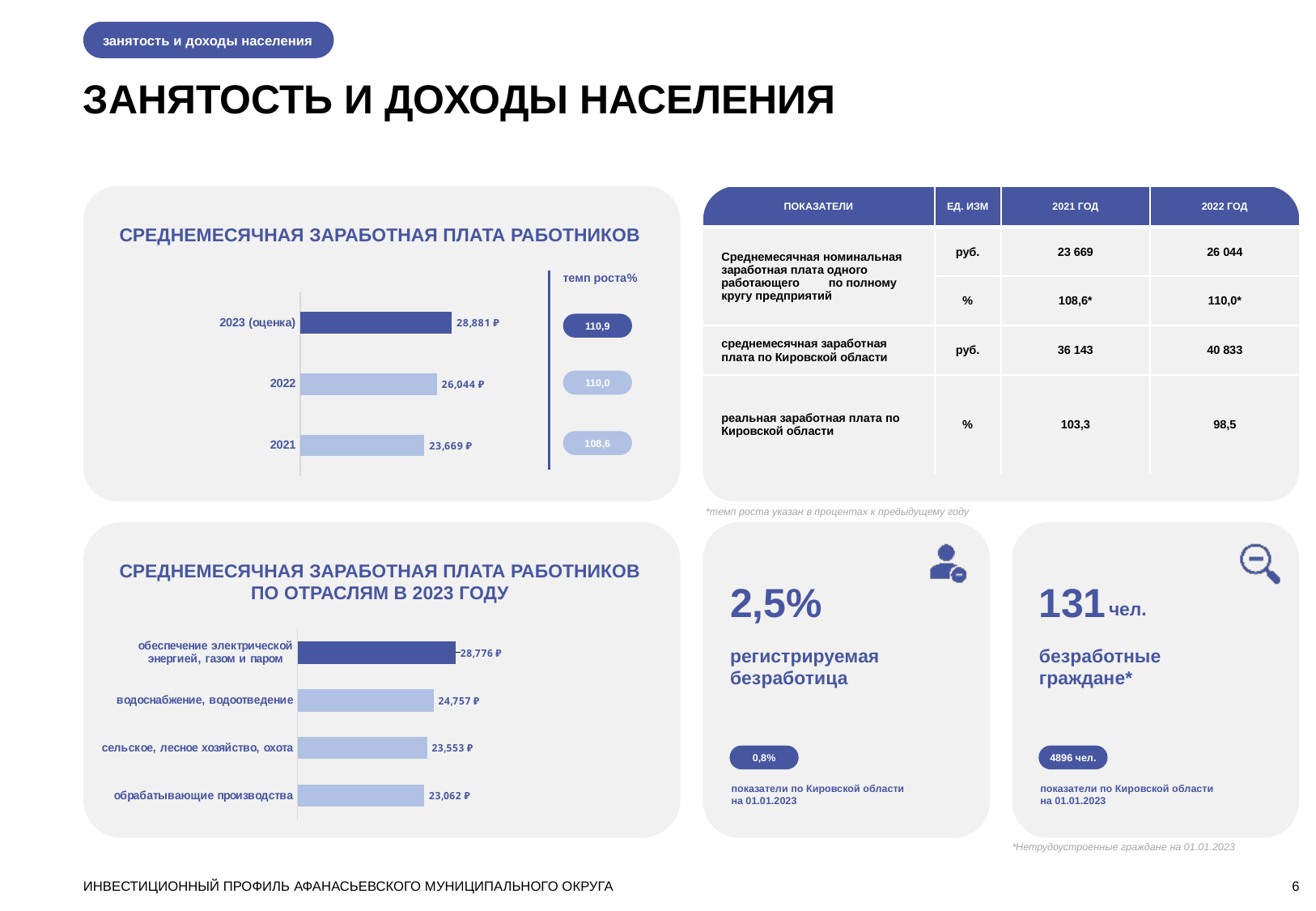
On the chart 'СРЕДНЕМЕСЯЧНАЯ ЗАРАБОТНАЯ ПЛАТА РАБОТНИКОВ', which year has the lowest value? 2021 On the chart 'СРЕДНЕМЕСЯЧНАЯ ЗАРАБОТНАЯ ПЛАТА РАБОТНИКОВ ПО ОТРАСЛЯМ В 2023 ГОДУ', which is larger: сельское, лесное хозяйство, охота or обрабатывающие производства? сельское, лесное хозяйство, охота On the chart 'СРЕДНЕМЕСЯЧНАЯ ЗАРАБОТНАЯ ПЛАТА РАБОТНИКОВ ПО ОТРАСЛЯМ В 2023 ГОДУ', what is the difference between обеспечение электрической энергией, газом и паром and обрабатывающие производства? 5,714 ₽ On the chart 'СРЕДНЕМЕСЯЧНАЯ ЗАРАБОТНАЯ ПЛАТА РАБОТНИКОВ ПО ОТРАСЛЯМ В 2023 ГОДУ', which industry has the highest value? обеспечение электрической энергией, газом и паром On the chart 'СРЕДНЕМЕСЯЧНАЯ ЗАРАБОТНАЯ ПЛАТА РАБОТНИКОВ', what is the value for 2021? 23,669 ₽ On the chart 'СРЕДНЕМЕСЯЧНАЯ ЗАРАБОТНАЯ ПЛАТА РАБОТНИКОВ', do the values rise or fall from 2021 to 2023 (оценка)? rise What kind of chart is 'СРЕДНЕМЕСЯЧНАЯ ЗАРАБОТНАЯ ПЛАТА РАБОТНИКОВ ПО ОТРАСЛЯМ В 2023 ГОДУ'? bar chart On the chart 'СРЕДНЕМЕСЯЧНАЯ ЗАРАБОТНАЯ ПЛАТА РАБОТНИКОВ', what is the difference between the 2023 (оценка) value and the 2022 value? 2,837 ₽ On the chart 'СРЕДНЕМЕСЯЧНАЯ ЗАРАБОТНАЯ ПЛАТА РАБОТНИКОВ', what is the темп роста% shown for 2022? 110,0 On the chart 'СРЕДНЕМЕСЯЧНАЯ ЗАРАБОТНАЯ ПЛАТА РАБОТНИКОВ ПО ОТРАСЛЯМ В 2023 ГОДУ', what is the value for водоснабжение, водоотведение? 24,757 ₽ On the chart 'СРЕДНЕМЕСЯЧНАЯ ЗАРАБОТНАЯ ПЛАТА РАБОТНИКОВ', what is the value for 2023 (оценка)? 28,881 ₽ On the chart 'СРЕДНЕМЕСЯЧНАЯ ЗАРАБОТНАЯ ПЛАТА РАБОТНИКОВ ПО ОТРАСЛЯМ В 2023 ГОДУ', how many industries are shown? 4